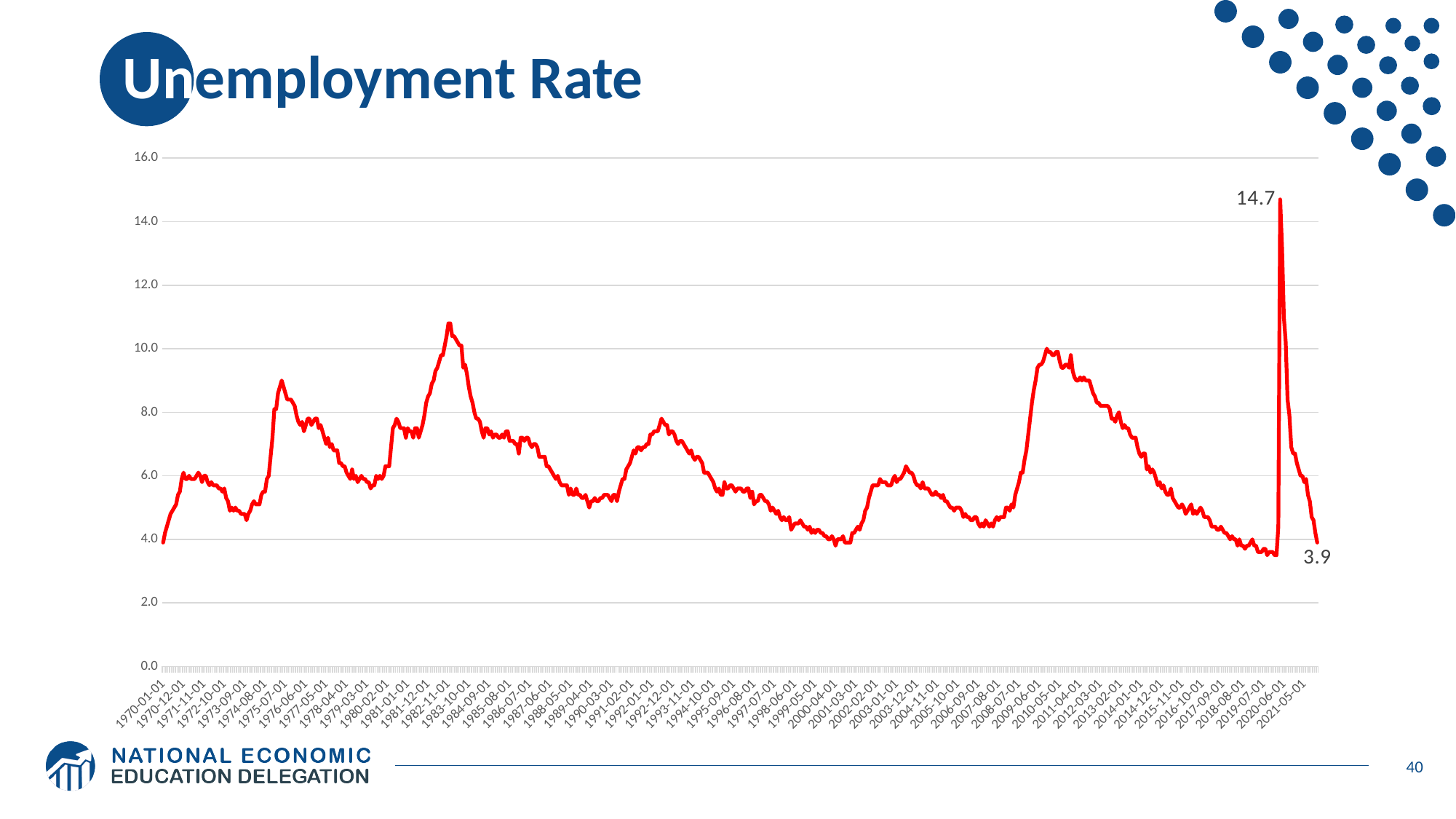
Is the unemployment rate around 2000-04-01 greater or less than 6.0? less Is the unemployment rate around 1975-07-01 greater or less than 8.0? greater Which peak is higher: the one around 2020 or the one around 1983? the one around 2020 What is the value of the last data point labeled on the chart, at the right end of the line? 3.9 What is the difference between the labeled peak value of 14.7 and the labeled final value of 3.9? 10.8 Is the unemployment rate at its peak around 1983 greater or less than 10.0? greater What is the title of the chart? Unemployment Rate What is the highest unemployment rate value labeled on the chart? 14.7 What kind of chart is shown on the slide? line chart What colour is the line plotted on the chart? red Between about 2010 and 2019, does the unemployment rate generally rise or fall? fall